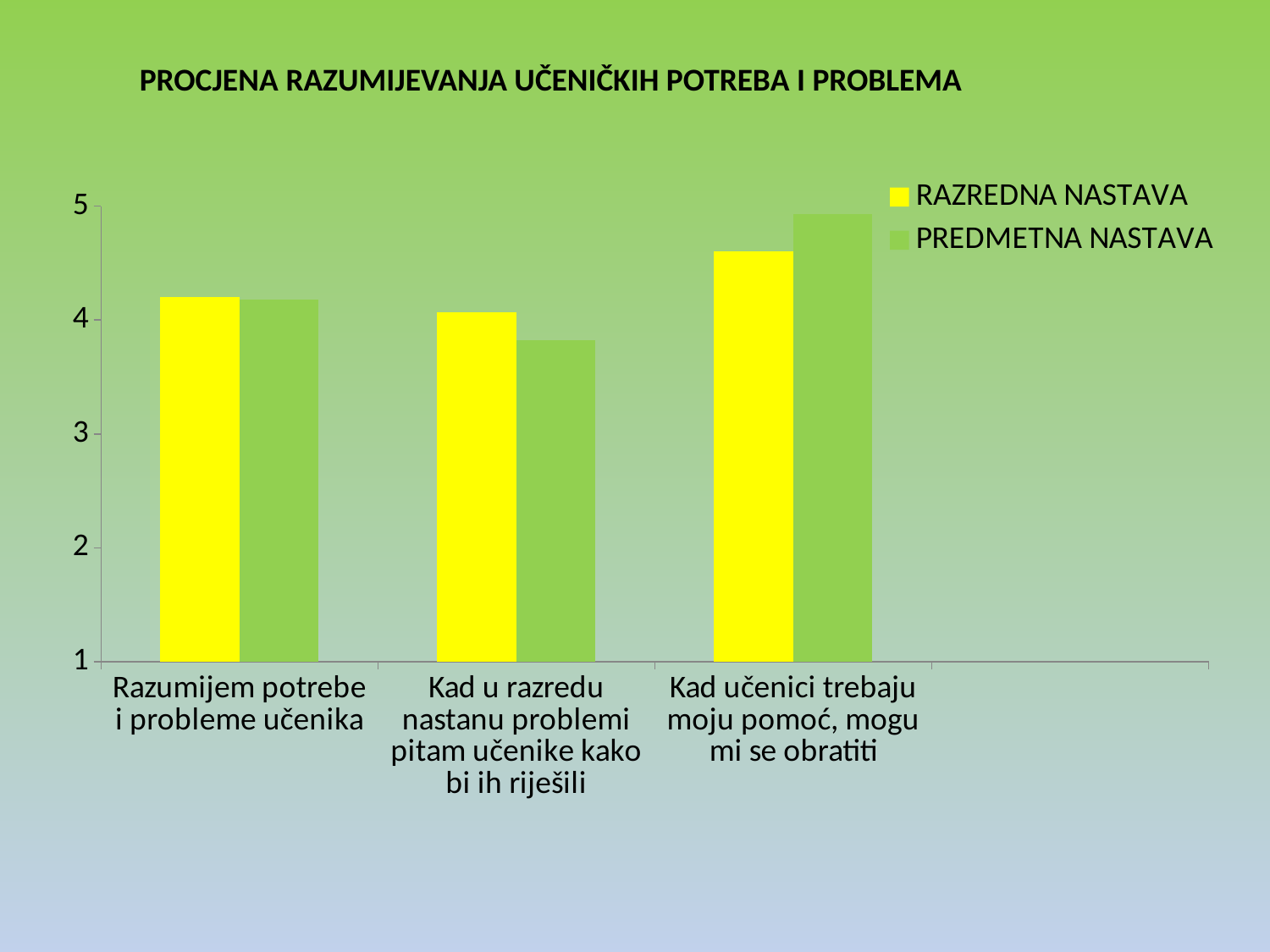
What is the title of the chart? PROCJENA RAZUMIJEVANJA UČENIČKIH POTREBA I PROBLEMA For "Kad učenici trebaju moju pomoć, mogu mi se obratiti", which series has the larger value, RAZREDNA NASTAVA or PREDMETNA NASTAVA? PREDMETNA NASTAVA Is the RAZREDNA NASTAVA value for "Razumijem potrebe i probleme učenika" greater or less than 4? greater For "Kad u razredu nastanu problemi pitam učenike kako bi ih riješili", which series has the larger value, RAZREDNA NASTAVA or PREDMETNA NASTAVA? RAZREDNA NASTAVA How many series does the legend list? 2 Is the PREDMETNA NASTAVA value for "Kad u razredu nastanu problemi pitam učenike kako bi ih riješili" greater or less than 4? less For which category is the PREDMETNA NASTAVA value highest? Kad učenici trebaju moju pomoć, mogu mi se obratiti Is the PREDMETNA NASTAVA value for "Kad učenici trebaju moju pomoć, mogu mi se obratiti" greater or less than 4? greater Which series is shown in yellow in the chart? RAZREDNA NASTAVA How many categories are shown on the x axis of the chart? 3 For which category is the PREDMETNA NASTAVA value lowest? Kad u razredu nastanu problemi pitam učenike kako bi ih riješili What kind of chart is shown on the slide? bar chart